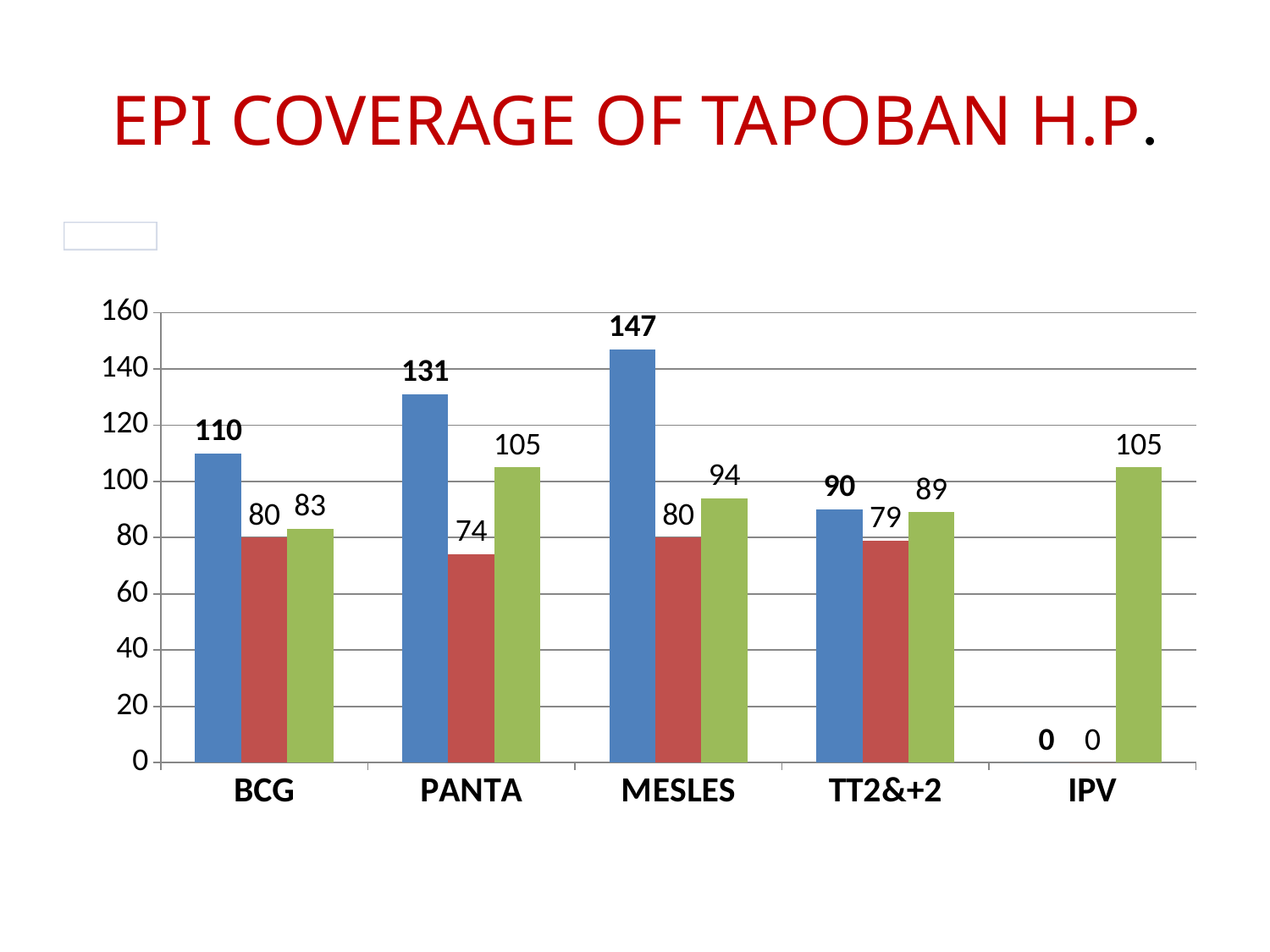
How many categories are shown on the x axis? 5 Which category has the highest blue bar? MESLES What is the value of the blue bar for IPV? 0 What is the value of the red bar for TT2&+2? 79 Which category has the lowest green bar? BCG What is the value of the blue bar for MESLES? 147 What is the difference between the blue bar and the red bar for PANTA? 57 Is the value of the blue bar for BCG greater or less than 100? greater What kind of chart is shown on the slide? bar chart What is the value of the green bar for PANTA? 105 Which is larger for BCG, the red bar or the green bar? the green bar What is the title of the slide? EPI COVERAGE OF TAPOBAN H.P.